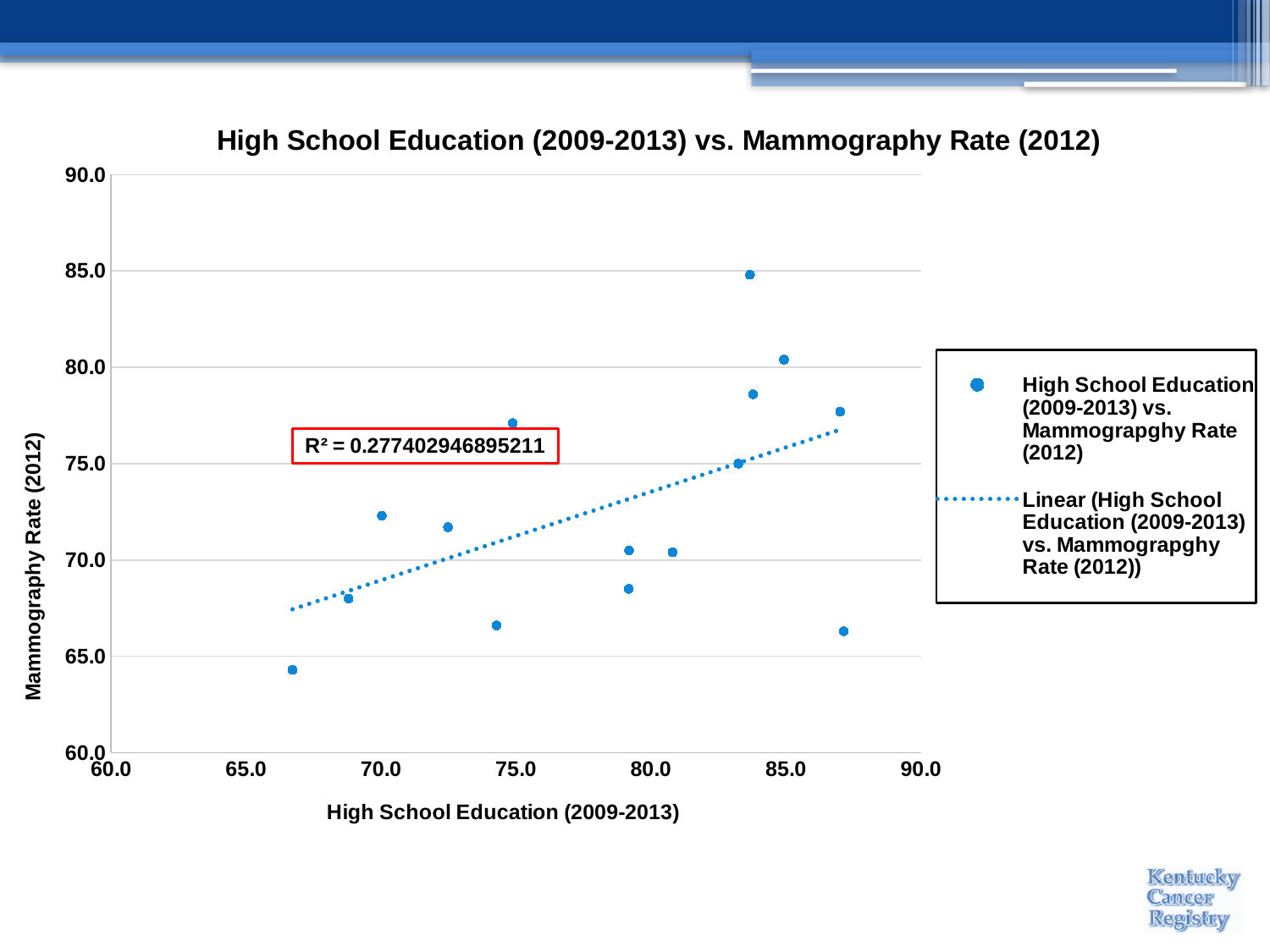
How many data points are plotted on the scatter chart? 15 How many entries does the chart legend list? 2 What is the maximum value shown on the y axis? 90.0 What is the title of the chart? High School Education (2009-2013) vs. Mammography Rate (2012) What is the label of the y axis? Mammography Rate (2012) What kind of chart is shown on the slide? Scatter chart What R² value is printed on the chart? R² = 0.277402946895211 Is the mammography rate of the lowest point on the chart greater or less than 65.0? less Is the mammography rate of the highest point on the chart greater or less than 80.0? greater What is the minimum value shown on the x axis? 60.0 Does the dotted linear trendline rise or fall as High School Education increases along the x axis? Rises Is the mammography rate of the leftmost point (at about 66.7 on the x axis) greater or less than 65.0? less